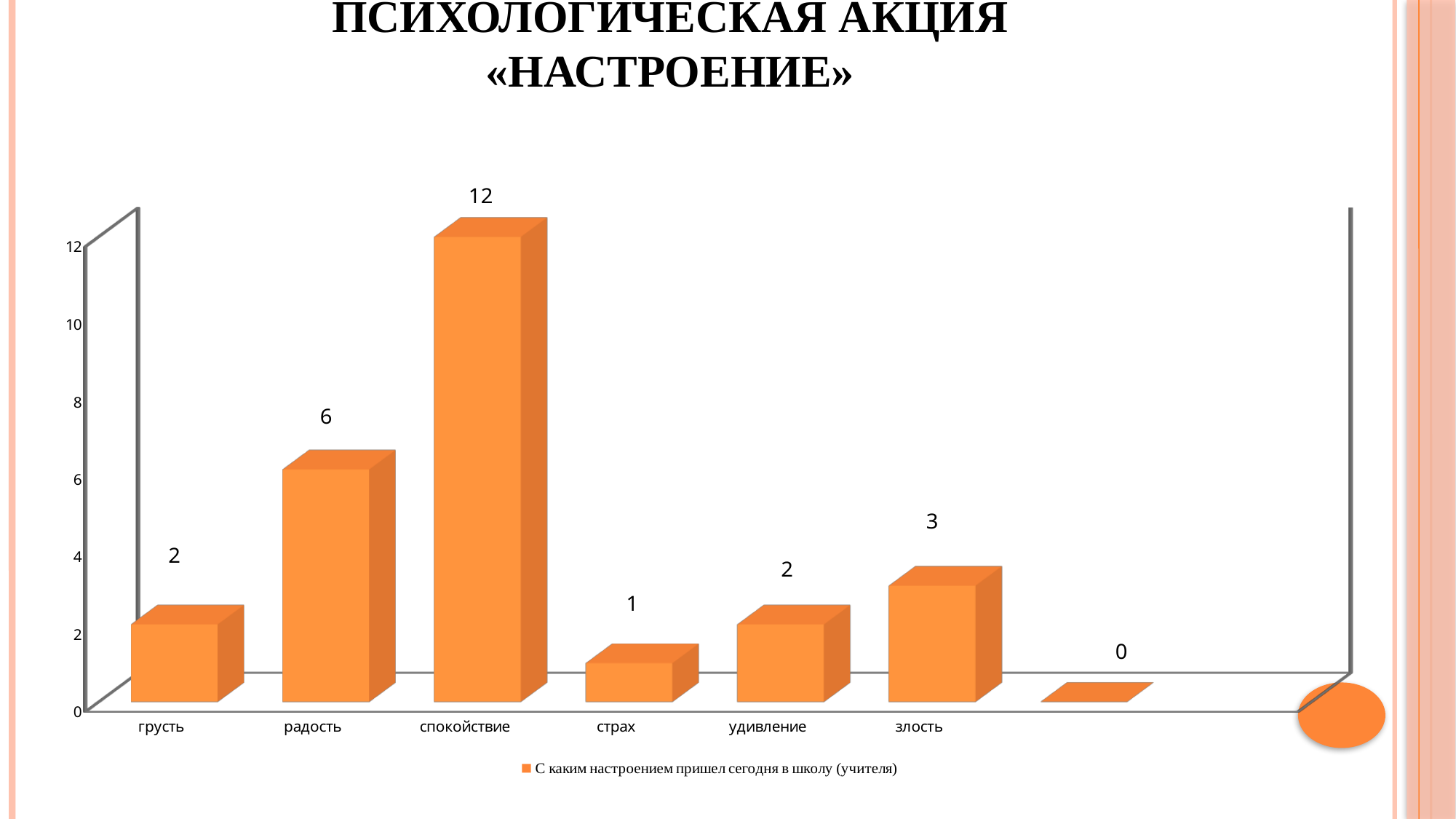
Is the value for радость greater or less than 4? greater What is the legend entry of the chart? С каким настроением пришел сегодня в школу (учителя) What is the value for спокойствие? 12 What is the difference between the values for спокойствие and радость? 6 Which category has the highest value? спокойствие How many series does the legend list? 1 What kind of chart is shown on the slide? bar chart Which is larger, the value for грусть or the value for злость? злость What is the value for радость? 6 Among the categories labeled on the x axis, which has the lowest value? страх What is the value for злость? 3 What is the value for страх? 1